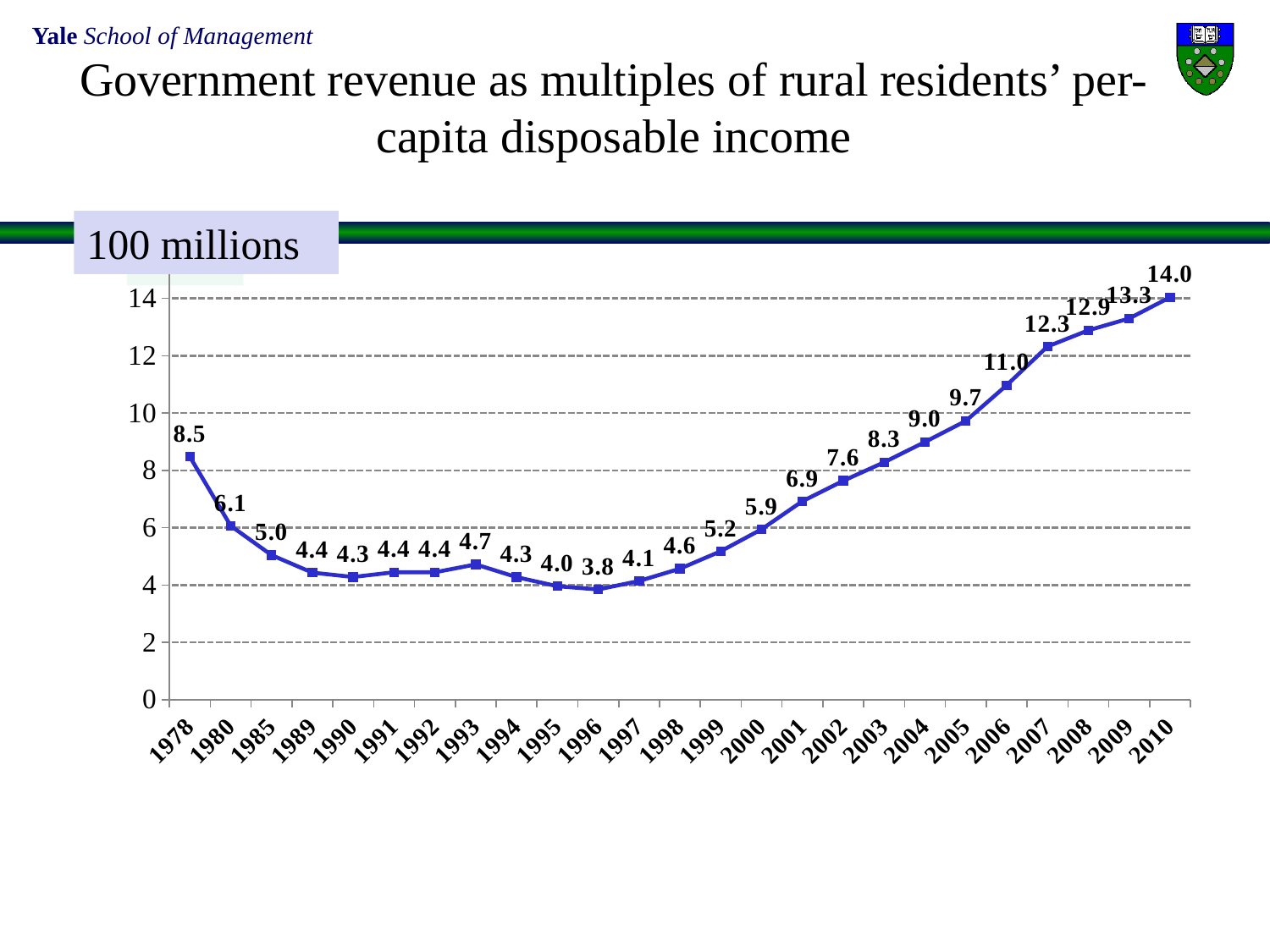
What is the value for 2006? 11.0 What is the difference between the values for 2006 and 2005? 1.3 What is the difference between the values for 2010 and 1978? 5.5 Do the values rise or fall from 1996 to 2010? rise What is the value for 1996? 3.8 What unit label is shown above the chart? 100 millions What is the value for 1978? 8.5 Which year has the highest value? 2010 What type of chart is shown on the slide? line chart How many years are plotted on the x axis? 25 Which year has the lowest value? 1996 Which is larger, the value for 1978 or the value for 2004? 2004